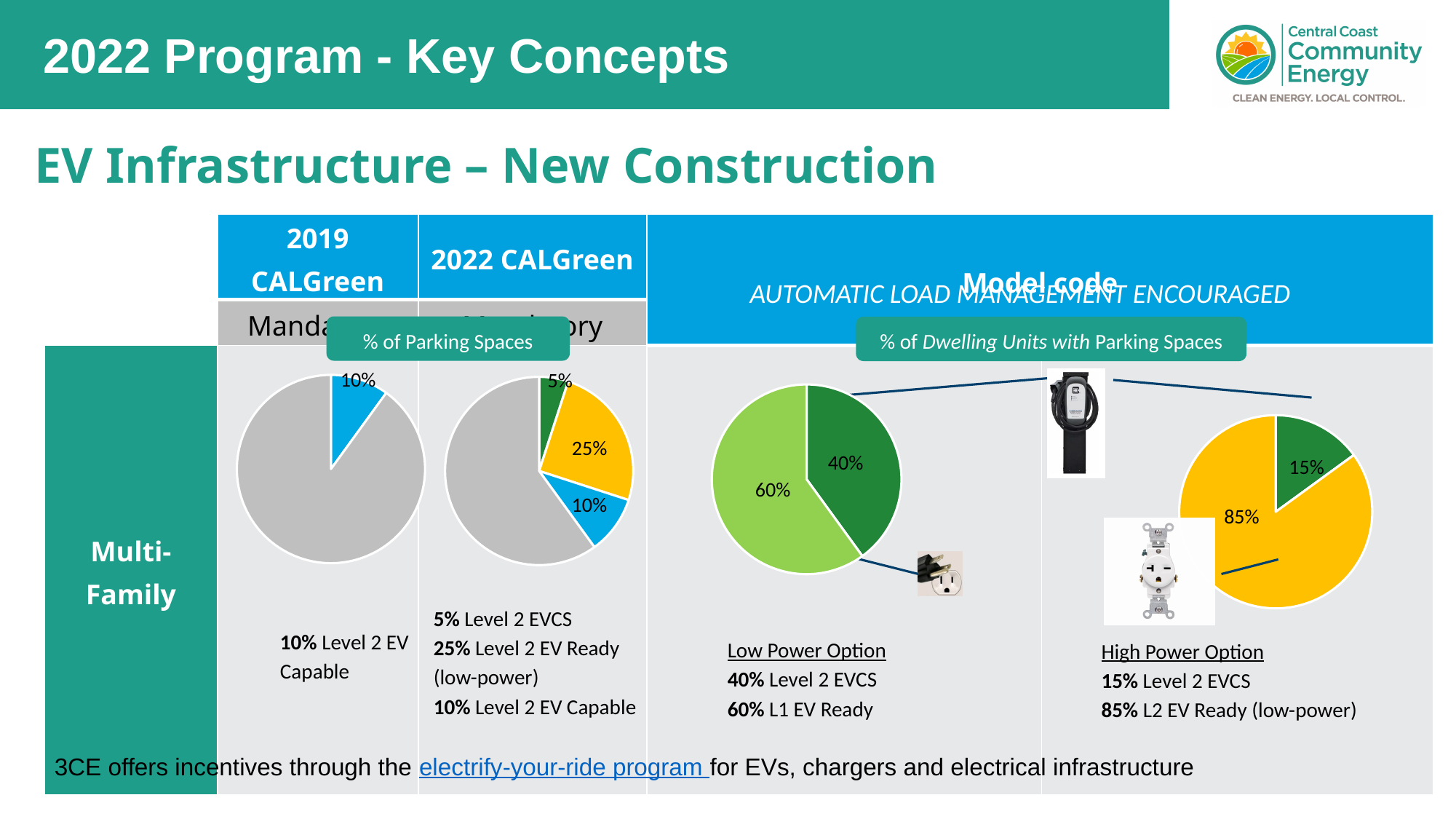
In the Low Power Option pie chart, what percentage is shown for L1 EV Ready? 60% In the High Power Option pie chart, what percentage is shown for L2 EV Ready (low-power)? 85% What type of chart is used for the Low Power Option? Pie chart How many pie charts are shown on the slide? 4 Which is larger: the Level 2 EVCS share in the Low Power Option chart or in the High Power Option chart? Low Power Option In the 2022 CALGreen pie chart, which of the three labelled slices is the largest? 25% (Level 2 EV Ready) In the 2022 CALGreen pie chart, what percentage is shown for Level 2 EVCS? 5% In the 2022 CALGreen pie chart, what percentage is shown for Level 2 EV Ready (low-power)? 25% In the Low Power Option pie chart, what is the difference between the L1 EV Ready share and the Level 2 EVCS share? 20% In the High Power Option pie chart, what percentage is shown for Level 2 EVCS? 15% In the 2022 CALGreen pie chart, which of the three labelled slices is the smallest? 5% (Level 2 EVCS) In the 2019 CALGreen pie chart, what percentage is labelled for Level 2 EV Capable? 10%